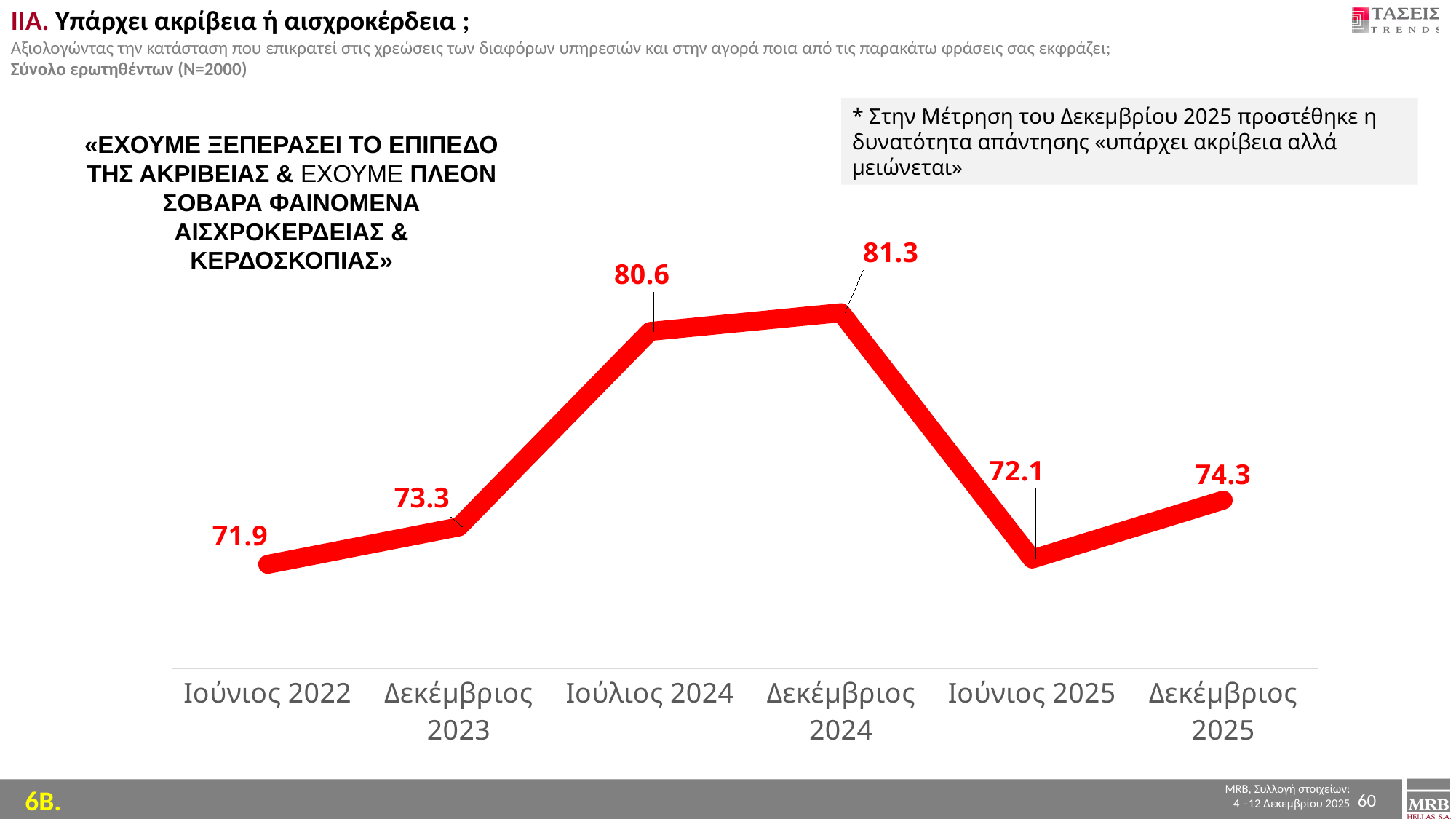
What is the difference between the values for Ιούλιος 2024 and Δεκέμβριος 2023? 7.3 Does the value rise or fall from Δεκέμβριος 2024 to Ιούνιος 2025? Fall What is the value for Δεκέμβριος 2024? 81.3 What kind of chart is shown on the slide? Line chart How many time points are plotted on the chart? 6 What is the value for Ιούνιος 2025? 72.1 What is the value for Ιούνιος 2022? 71.9 What is the value for Δεκέμβριος 2025? 74.3 Which is larger, the value for Δεκέμβριος 2025 or the value for Δεκέμβριος 2023? Δεκέμβριος 2025 Which time point has the highest value? Δεκέμβριος 2024 Which time point has the lowest value? Ιούνιος 2022 What is the difference between the values for Δεκέμβριος 2024 and Ιούνιος 2025? 9.2